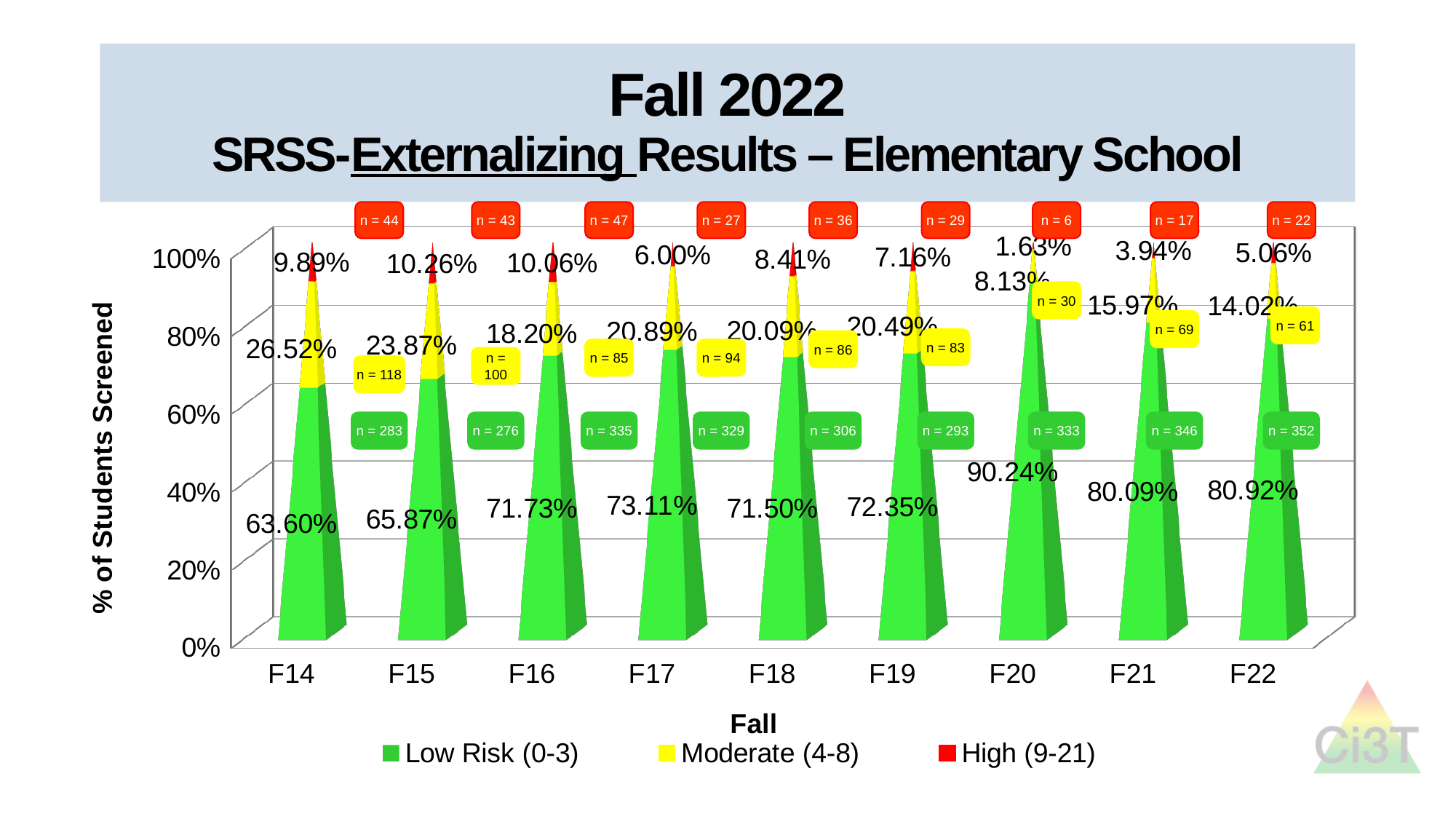
Which fall has the highest Low Risk (0-3) percentage? F20 How many series does the legend list? 3 What is the label on the y axis? % of Students Screened Which fall has the lowest High (9-21) percentage? F20 What is the High (9-21) percentage for F22? 5.06% What is the Low Risk (0-3) percentage for F14? 63.60% What is the difference between the Low Risk (0-3) percentages for F22 and F21? 0.83% What kind of chart is shown on the slide? Stacked bar chart How many students were in the Low Risk (0-3) group in F21 (the n value)? n = 346 What is the Moderate (4-8) percentage for F17? 20.89% How many fall semesters are shown on the x axis? 9 Which is larger, the Moderate (4-8) percentage for F14 or for F15? F14